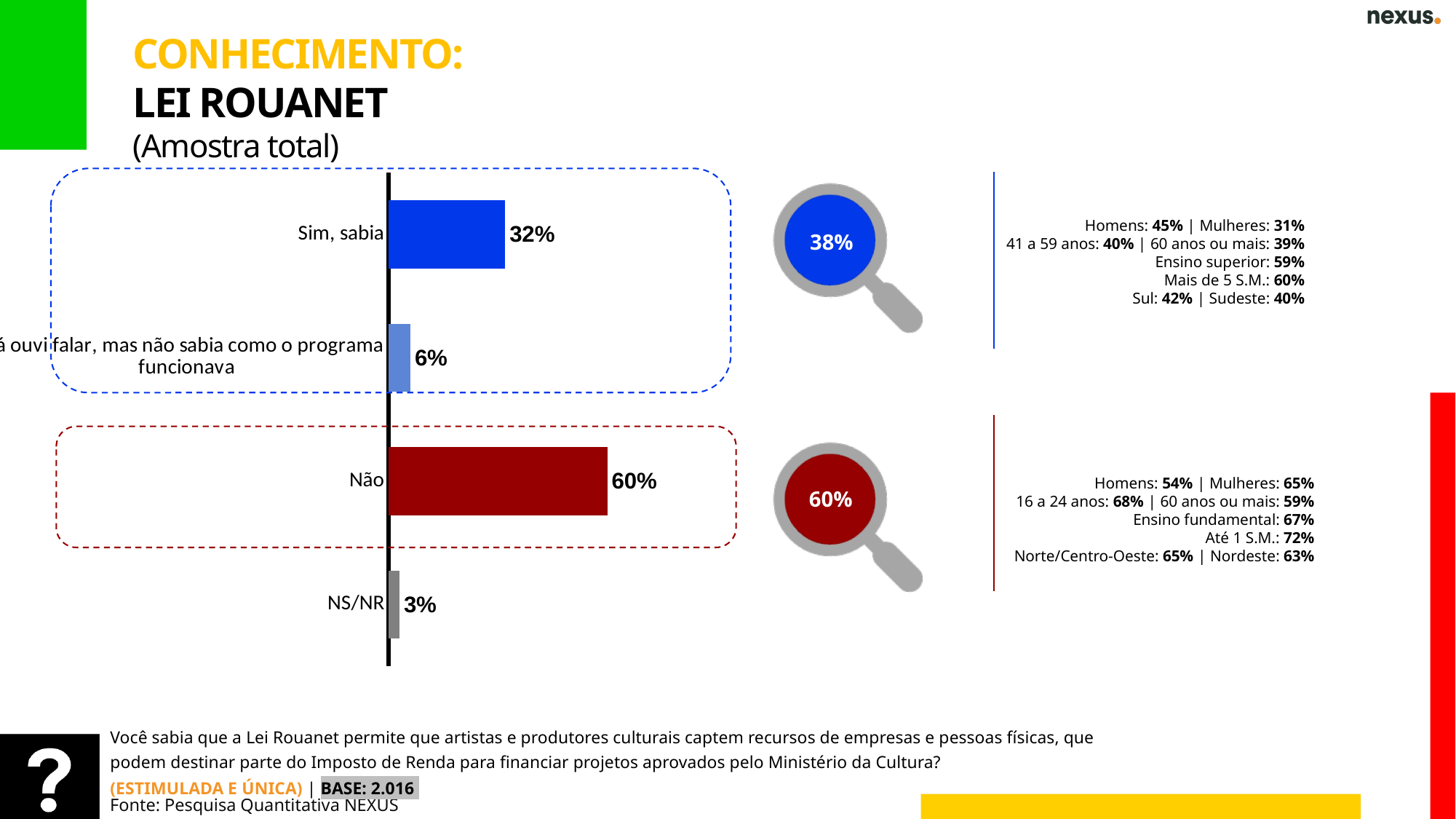
How many categories are shown in the bar chart? 4 What is the value for "Não"? 60% What is the value for "NS/NR"? 3% What is the value for "Sim, sabia"? 32% What is the value for the category "Já ouvi falar, mas não sabia como o programa funcionava"? 6% Which is larger, the value for "Sim, sabia" or the value for "NS/NR"? Sim, sabia What colour is the bar for "Não"? Dark red What kind of chart is shown on the slide? Bar chart What percentage is shown inside the blue magnifying-glass circle? 38% What is the difference between the values for "Não" and "Sim, sabia"? 28% Which category has the lowest value? NS/NR Which category has the highest value? Não